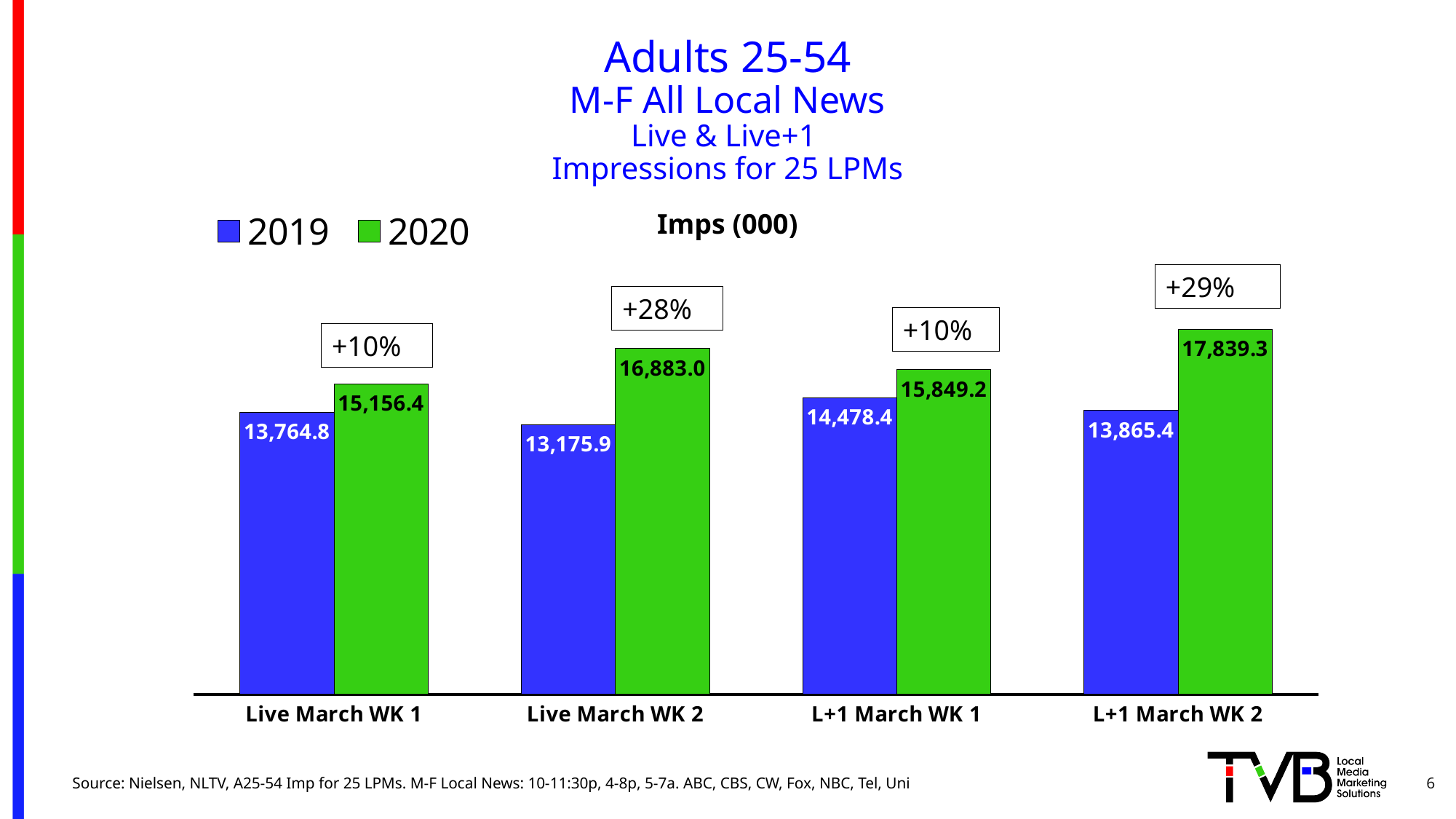
Which category has the lowest 2019 value? Live March WK 2 Which category has the highest 2020 value? L+1 March WK 2 What is the 2020 value for L+1 March WK 2? 17,839.3 What is the 2020 value for Live March WK 2? 16,883.0 How many series does the legend list? 2 What is the difference between the 2020 and 2019 values for Live March WK 1? 1,391.6 How many categories are shown on the x axis? 4 What is the difference between the 2020 and 2019 values for L+1 March WK 2? 3,973.9 Which is larger, the 2019 value for L+1 March WK 1 or the 2019 value for Live March WK 2? L+1 March WK 1 What kind of chart is shown on the slide? Bar chart What is the 2019 value for L+1 March WK 1? 14,478.4 What percentage change is shown above the Live March WK 2 bars? +28%